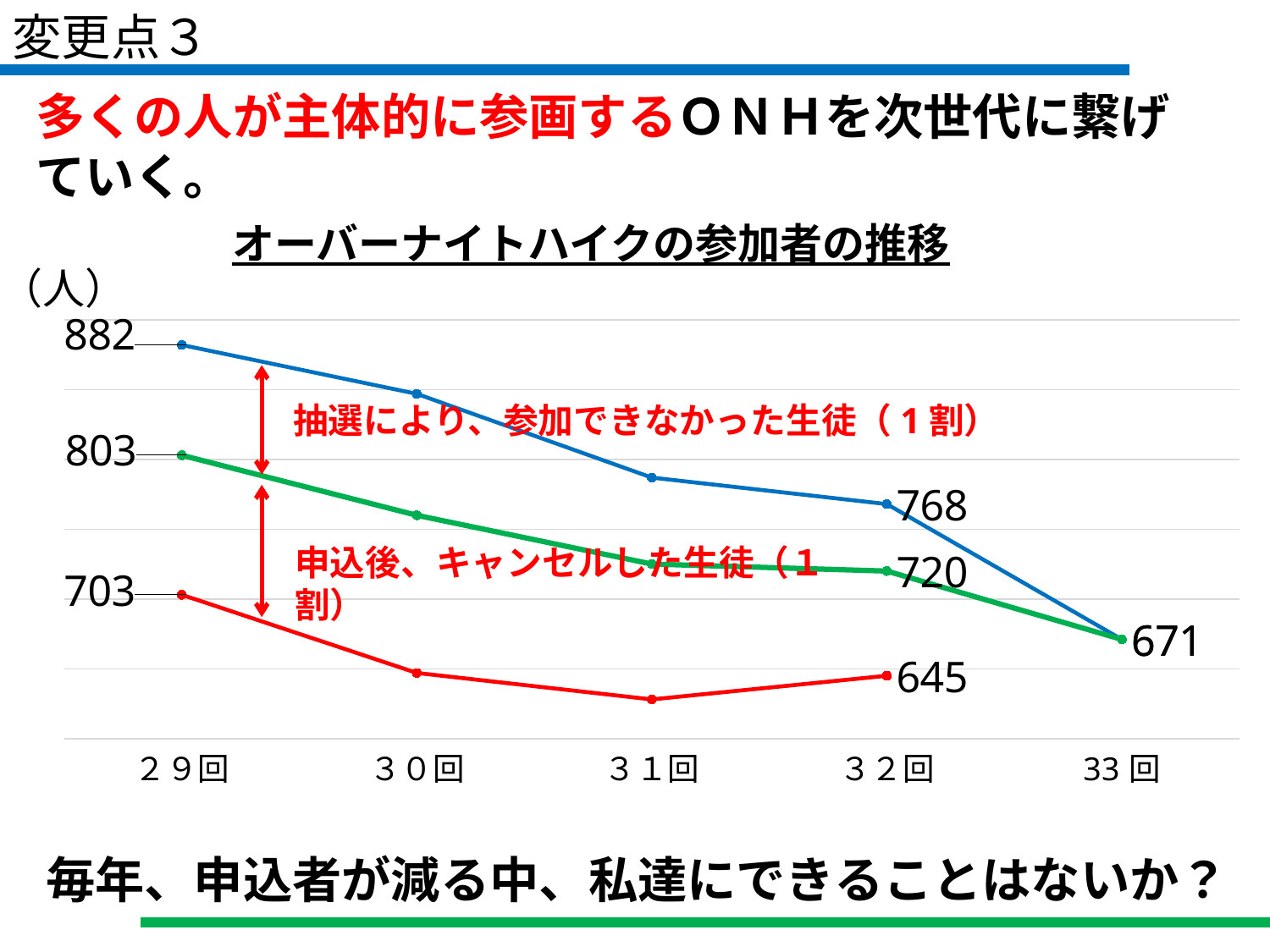
What is the title of the chart? オーバーナイトハイクの参加者の推移 How many categories (回) are shown on the x axis? 5 What is the value of the red line at 29回? 703 What is the value of the red line at 32回? 645 What is the value of the green line at 29回? 803 What is the difference between the blue line value at 32回 (768) and the green line value at 32回 (720)? 48 How many lines are plotted on the chart? 3 What kind of chart is shown on the slide? line chart What value do the blue and green lines reach at 33回? 671 What is the value of the blue line at 29回? 882 Does the blue line rise or fall from 29回 to 33回? fall What is the difference between the blue line and the green line at 29回? 79